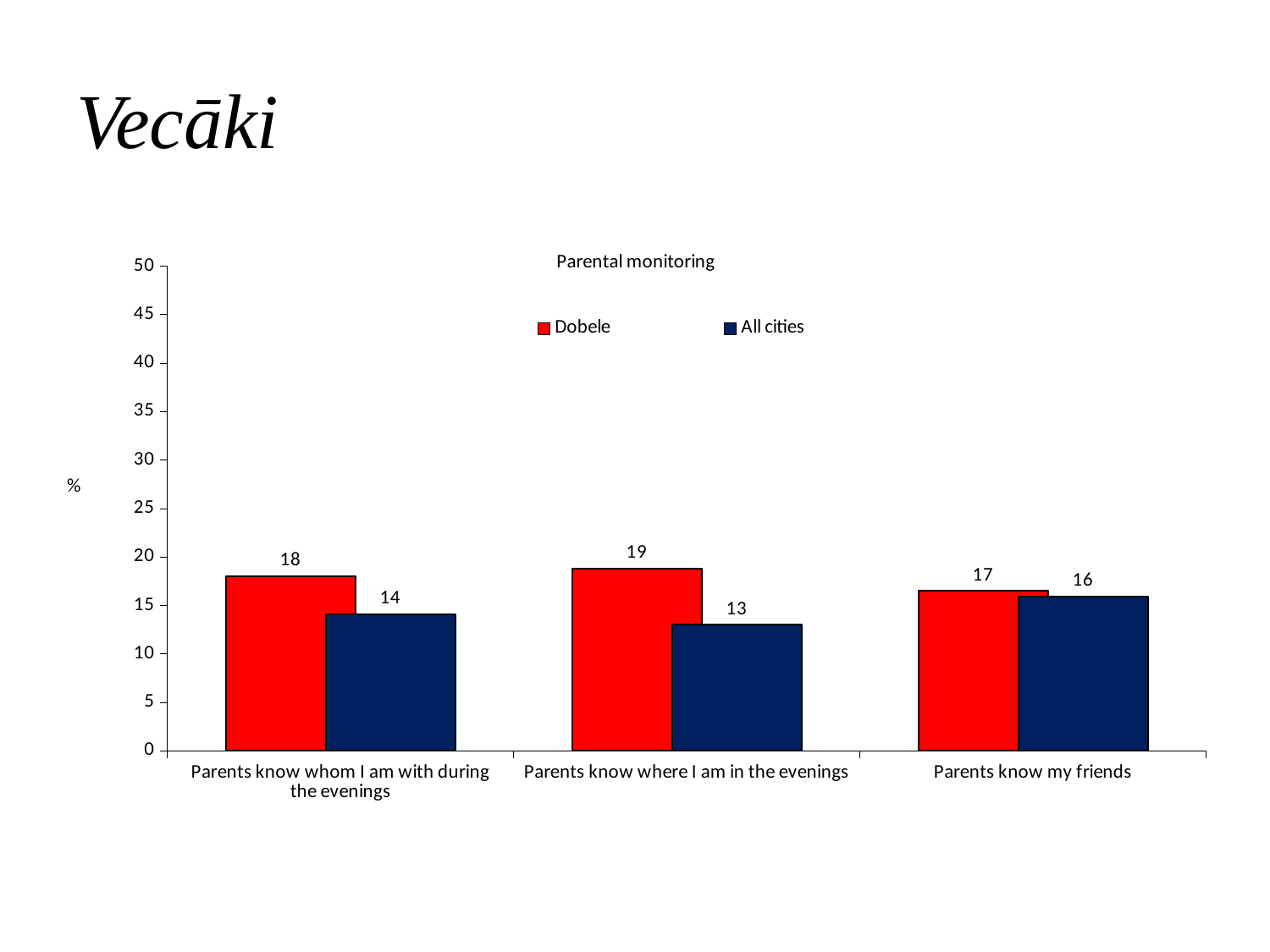
What is the All cities value for "Parents know my friends"? 16 Is the Dobele value for "Parents know my friends" greater or less than 20? less How many categories are shown on the x axis? 3 Which category has the highest Dobele value? Parents know where I am in the evenings What is the All cities value for "Parents know where I am in the evenings"? 13 What is the title of the chart? Parental monitoring Which category has the lowest All cities value? Parents know where I am in the evenings What is the difference between the Dobele and All cities values for "Parents know where I am in the evenings"? 6 What is the Dobele value for "Parents know whom I am with during the evenings"? 18 How many series does the legend list? 2 What kind of chart is shown on the slide? bar chart Which is larger for "Parents know whom I am with during the evenings": the Dobele value or the All cities value? Dobele